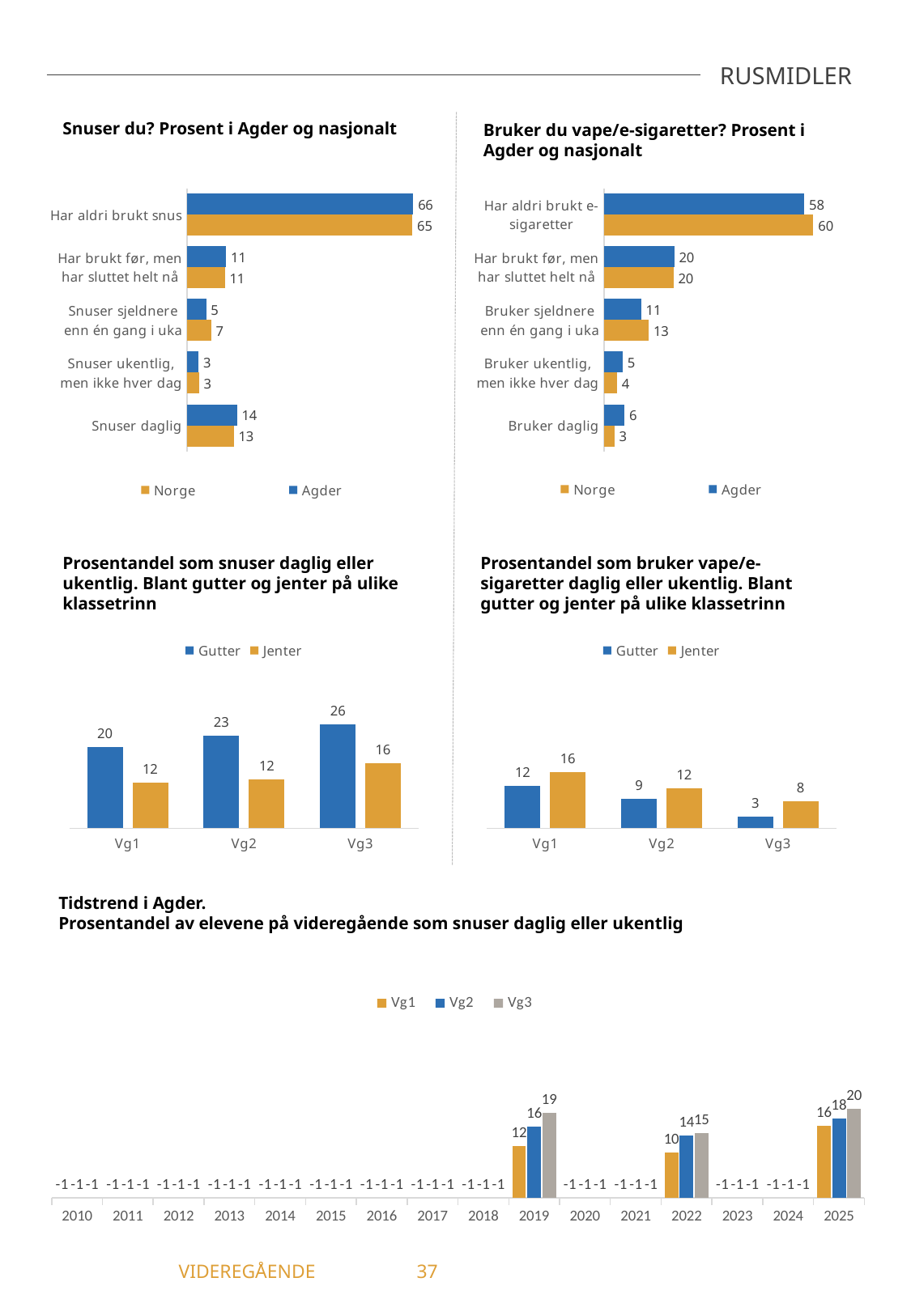
In the chart 'Prosentandel som snuser daglig eller ukentlig. Blant gutter og jenter på ulike klassetrinn', which class level has the highest value for Gutter? Vg3 In the chart 'Bruker du vape/e-sigaretter? Prosent i Agder og nasjonalt', which is larger for 'Har aldri brukt e-sigaretter', Agder or Norge? Norge In the chart 'Snuser du? Prosent i Agder og nasjonalt', what is the value for Agder for 'Har aldri brukt snus'? 66 How many series does the legend list in the chart 'Bruker du vape/e-sigaretter? Prosent i Agder og nasjonalt'? 2 In the chart 'Snuser du? Prosent i Agder og nasjonalt', what is the value for Norge for 'Snuser sjeldnere enn én gang i uka'? 7 What kind of chart is 'Tidstrend i Agder. Prosentandel av elevene på videregående som snuser daglig eller ukentlig'? bar chart In the chart 'Prosentandel som bruker vape/e-sigaretter daglig eller ukentlig. Blant gutter og jenter på ulike klassetrinn', which class level has the lowest value for Gutter? Vg3 In the chart 'Prosentandel som snuser daglig eller ukentlig. Blant gutter og jenter på ulike klassetrinn', do the Gutter values rise or fall from Vg1 to Vg3? rise In the chart 'Tidstrend i Agder', what is the value for Vg3 in 2025? 20 In the chart 'Prosentandel som bruker vape/e-sigaretter daglig eller ukentlig. Blant gutter og jenter på ulike klassetrinn', what is the difference between Jenter and Gutter at Vg1? 4 In the chart 'Prosentandel som snuser daglig eller ukentlig. Blant gutter og jenter på ulike klassetrinn', what is the value for Jenter at Vg2? 12 In the chart 'Bruker du vape/e-sigaretter? Prosent i Agder og nasjonalt', what is the difference between Agder and Norge for 'Bruker daglig'? 3